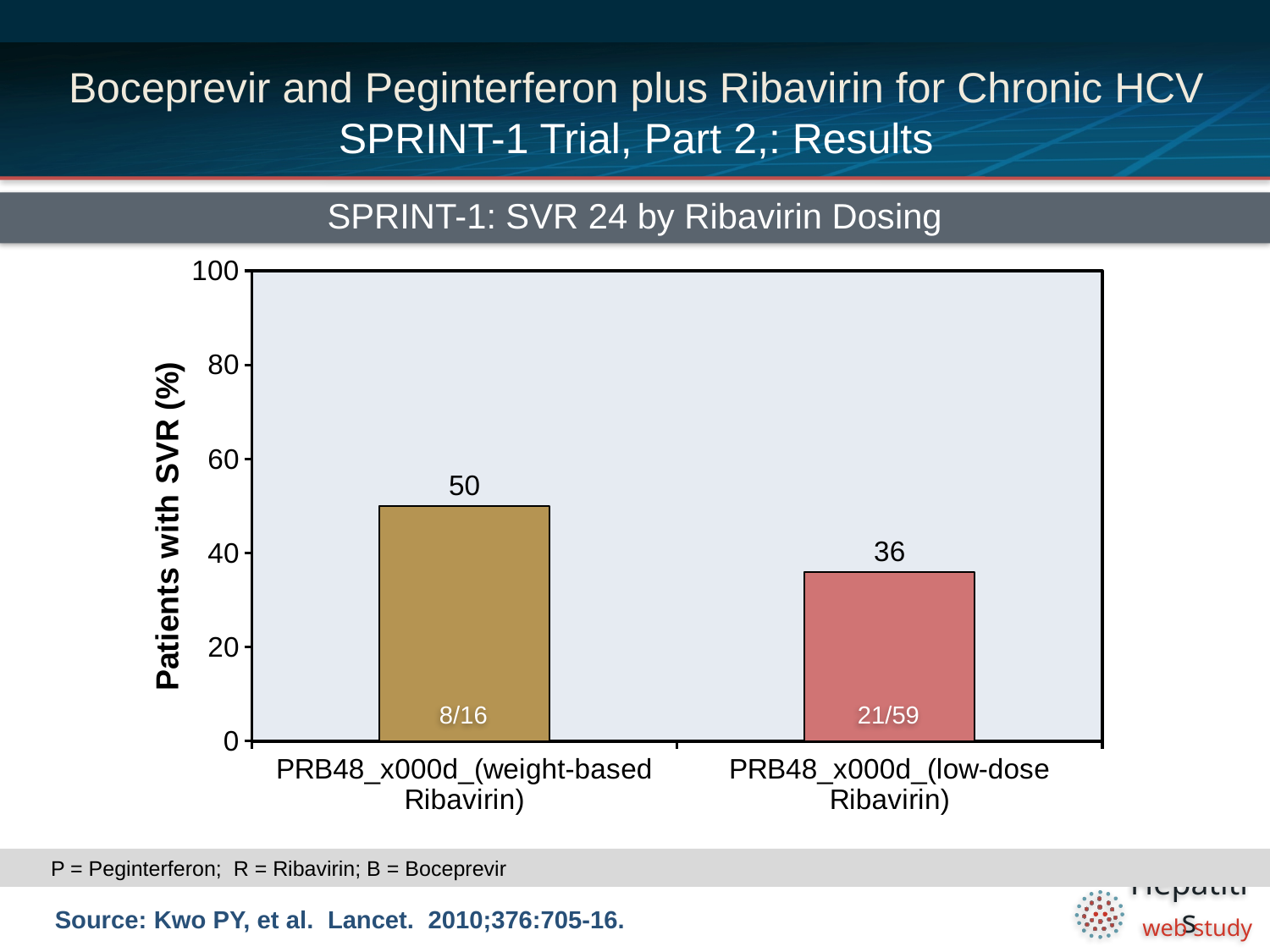
Which group has the lower SVR rate? PRB48 (low-dose Ribavirin) Is the SVR rate for the low-dose Ribavirin group greater or less than 40? less What is the title of the chart? SPRINT-1: SVR 24 by Ribavirin Dosing What fraction of patients is shown inside the bar for the weight-based Ribavirin group? 8/16 Which group has the higher SVR rate? PRB48 (weight-based Ribavirin) Is the SVR rate for the weight-based Ribavirin group greater or less than 40? greater What kind of chart is shown on the slide? Bar chart What is the difference in SVR rate (percentage points) between the weight-based and low-dose Ribavirin groups? 14 What is the SVR rate (%) for the PRB48 (low-dose Ribavirin) group? 36 What is the SVR rate (%) for the PRB48 (weight-based Ribavirin) group? 50 What fraction of patients is shown inside the bar for the low-dose Ribavirin group? 21/59 How many groups are plotted in the chart? 2